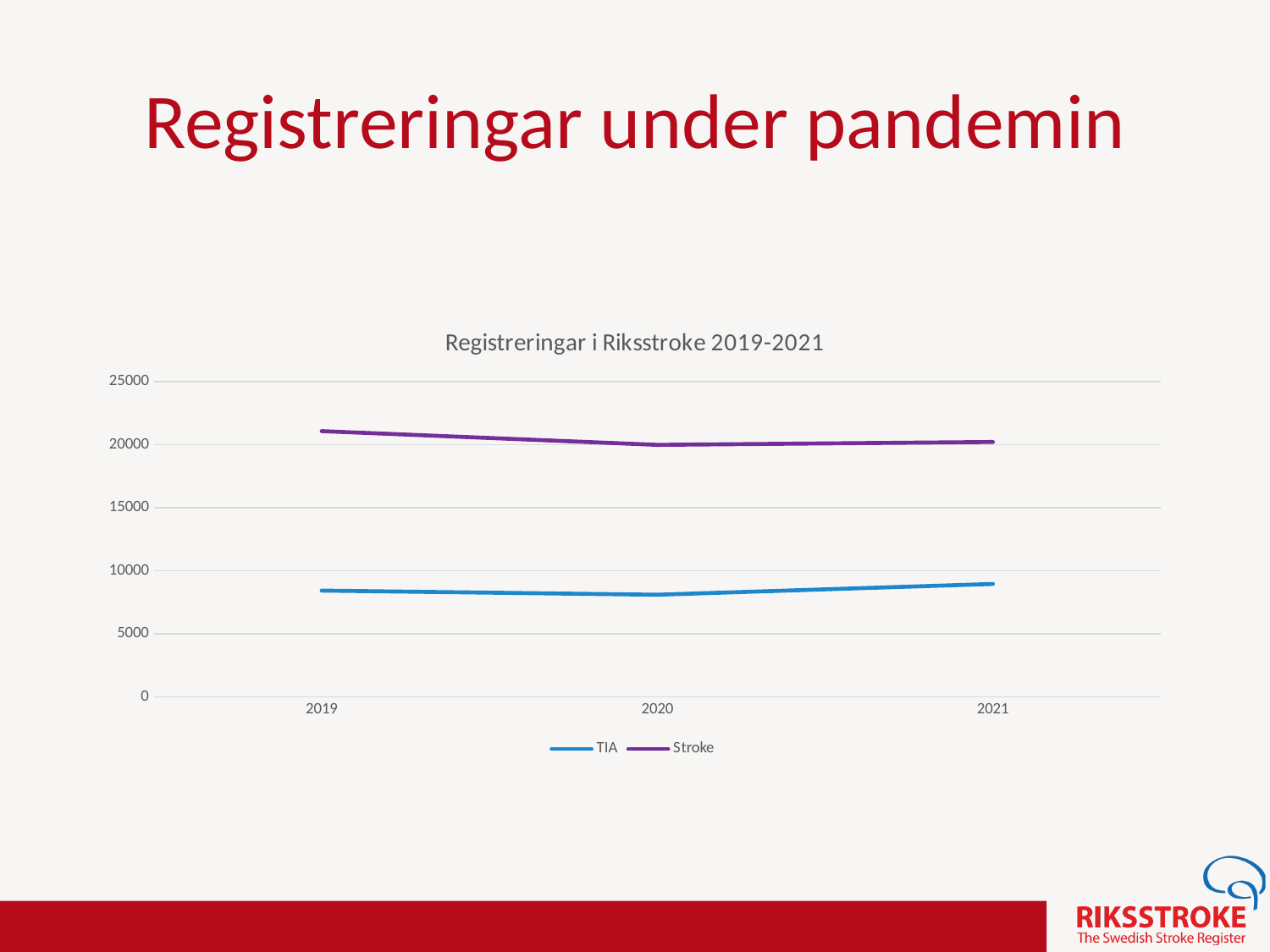
Is the value for TIA in 2021 greater or less than 10000? less How many series does the legend list? 2 Does the Stroke series rise or fall from 2019 to 2020? fall Is the value for Stroke in 2021 greater or less than 25000? less Which series has the higher value in 2020, TIA or Stroke? Stroke Is the value for TIA in 2020 greater or less than 5000? greater How many years are shown on the x axis? 3 In which year is the Stroke series highest? 2019 Which series are listed in the legend? TIA and Stroke What kind of chart is shown on the slide? line chart What is the title of the chart? Registreringar i Riksstroke 2019-2021